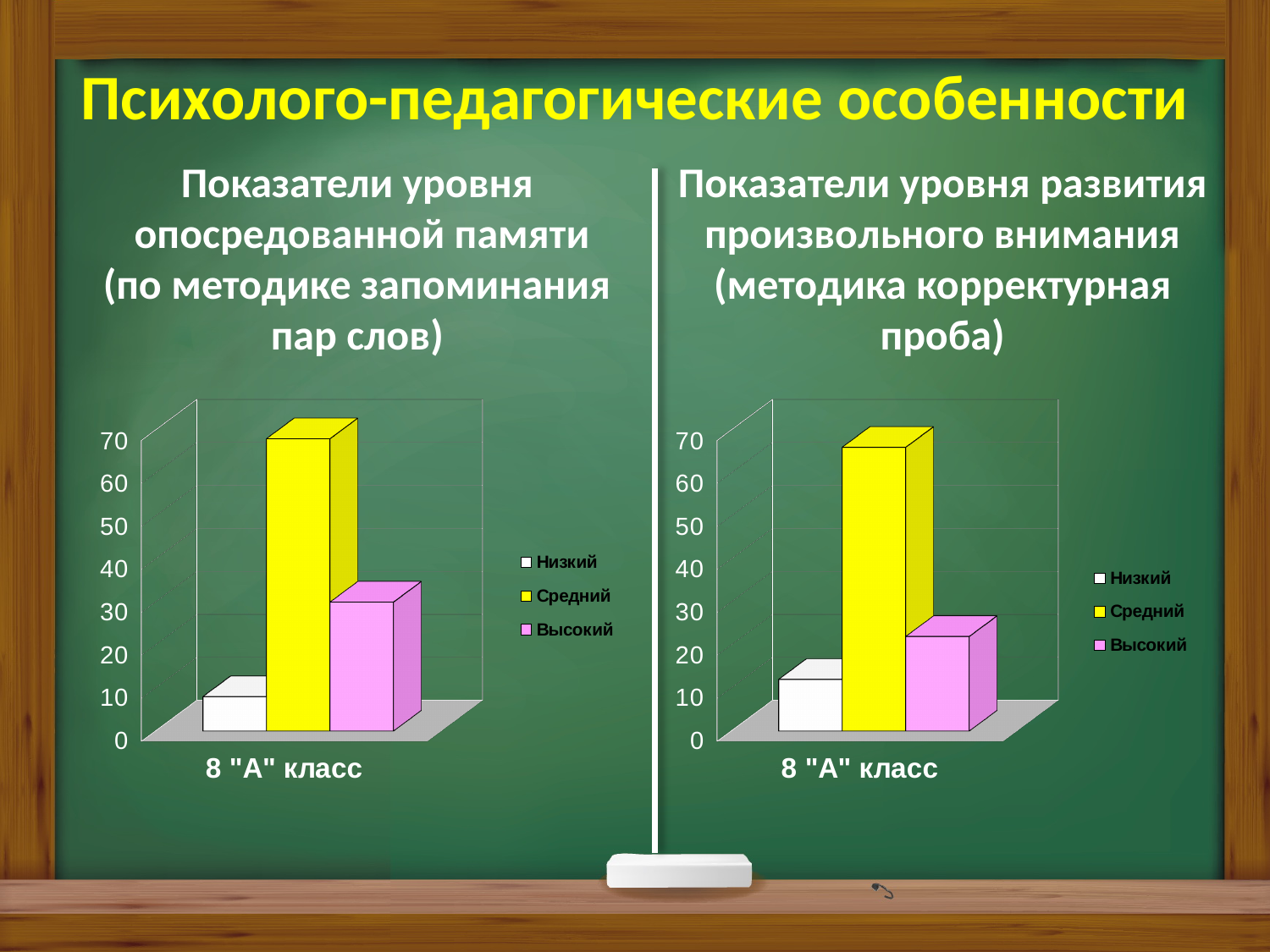
In the left chart, "Показатели уровня опосредованной памяти", is the value for Низкий greater or less than 20? less In the left chart, "Показатели уровня опосредованной памяти", which series has the lowest value? Низкий What kind of chart is the left chart, "Показатели уровня опосредованной памяти"? bar chart How many series does the legend of the right chart, "Показатели уровня развития произвольного внимания", list? 3 In the right chart, "Показатели уровня развития произвольного внимания", which series has the highest value? Средний In the right chart, "Показатели уровня развития произвольного внимания", is the value for Высокий greater or less than 40? less In the left chart, "Показатели уровня опосредованной памяти", which series has the highest value? Средний In the left chart, "Показатели уровня опосредованной памяти", which is larger: the value for Высокий or the value for Низкий? Высокий In the right chart, "Показатели уровня развития произвольного внимания", which series has the lowest value? Низкий In the left chart, "Показатели уровня опосредованной памяти", is the value for Средний greater or less than 60? greater What is the category label on the x axis of the right chart, "Показатели уровня развития произвольного внимания"? 8 "А" класс